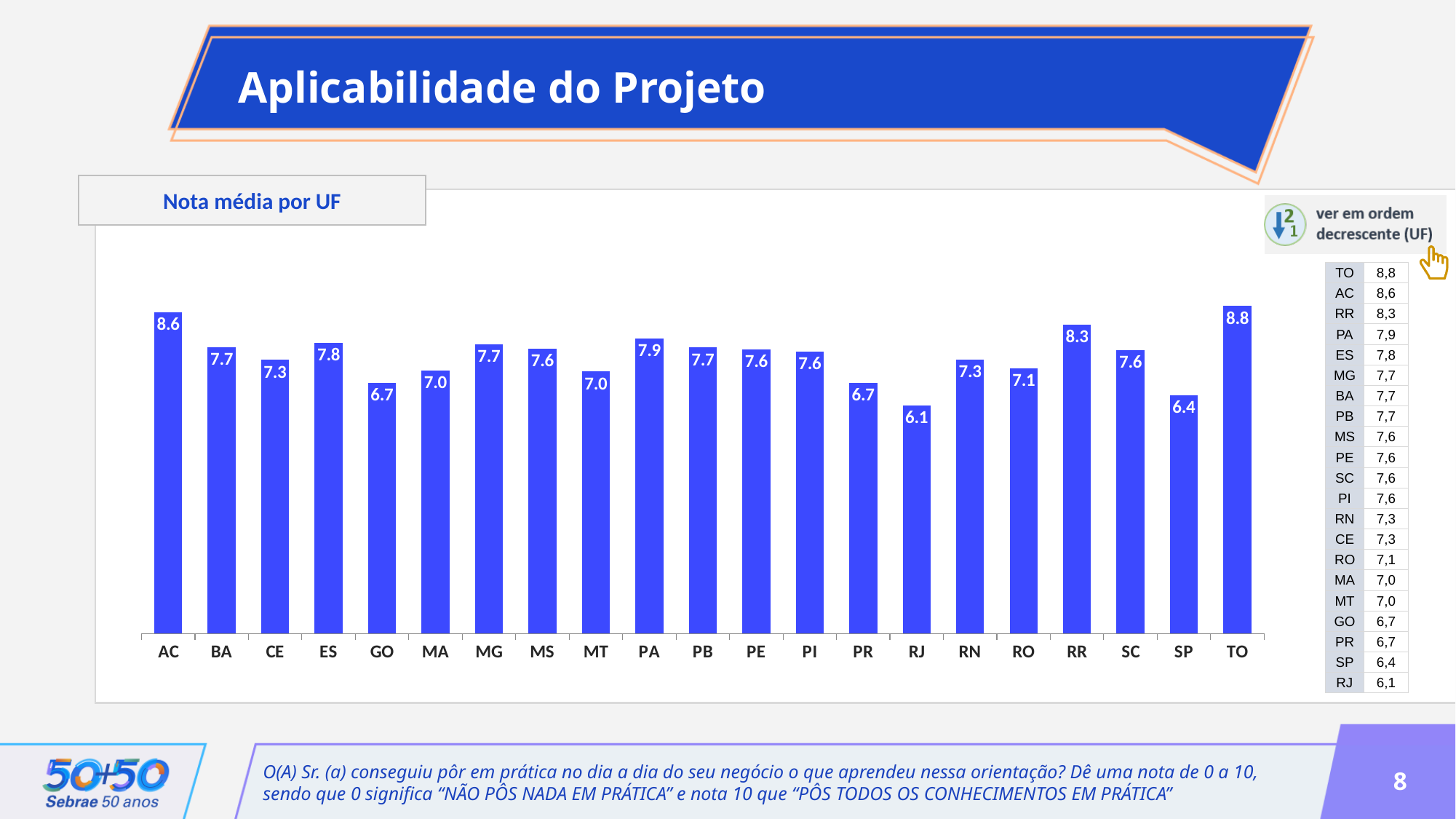
How many UFs are shown in the 'Nota média por UF' chart? 21 What kind of chart is the 'Nota média por UF' chart? Bar chart What is the value for PA in the 'Nota média por UF' chart? 7.9 Which is larger in the 'Nota média por UF' chart, the value for GO or the value for MA? MA What is the difference between the values for TO and RJ in the 'Nota média por UF' chart? 2.7 Which is larger in the 'Nota média por UF' chart, the value for RR or the value for ES? RR Which UF has the lowest value in the 'Nota média por UF' chart? RJ What is the title of the chart on the slide? Nota média por UF What is the value for RJ in the 'Nota média por UF' chart? 6.1 What is the difference between the values for AC and SP in the 'Nota média por UF' chart? 2.2 Which UF has the highest value in the 'Nota média por UF' chart? TO What is the value for TO in the 'Nota média por UF' chart? 8.8